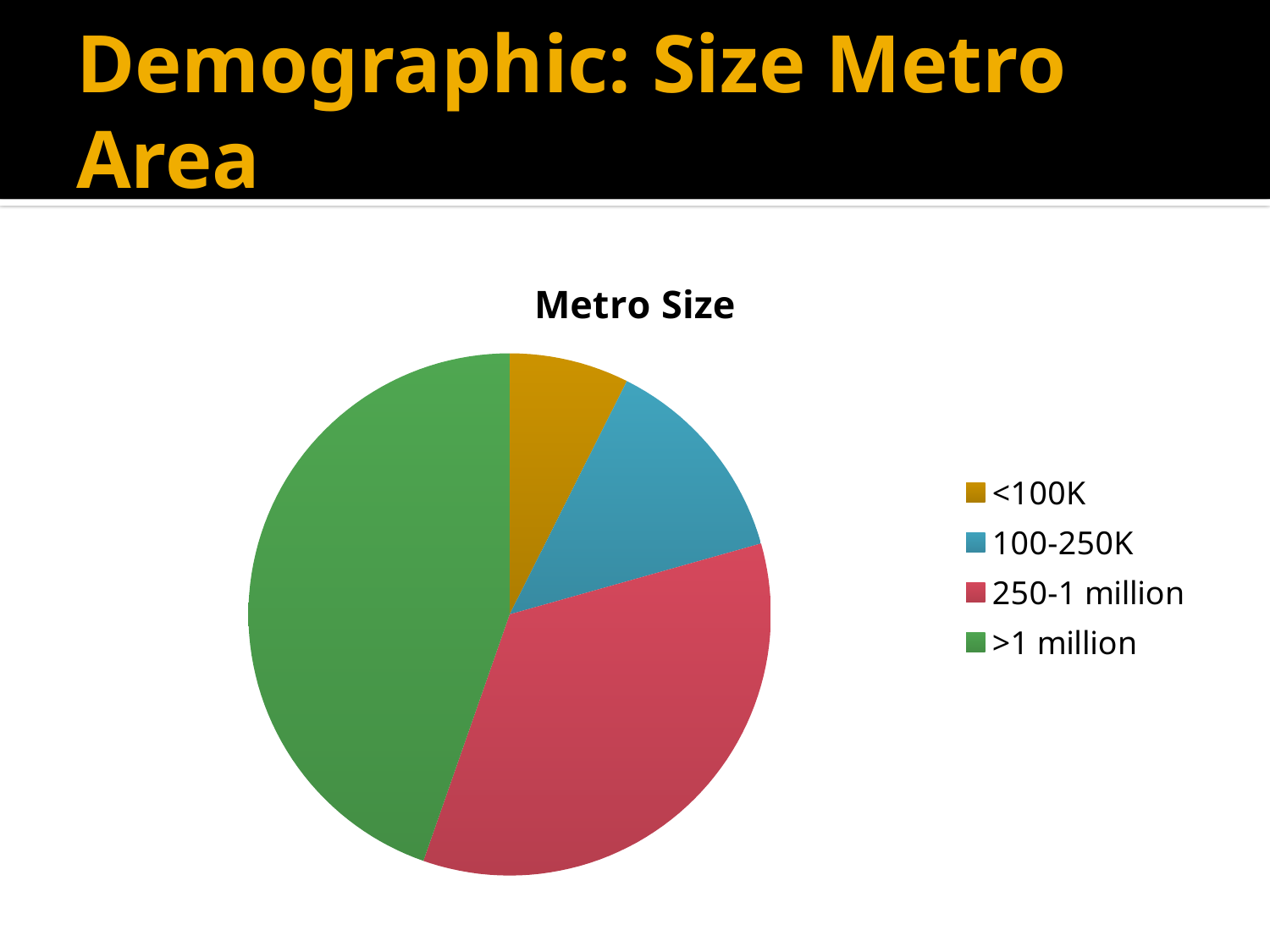
Which metro size category has the smallest slice of the pie? <100K How many slices does the pie chart have? 4 Which slice is larger, 100-250K or <100K? 100-250K Which colour represents the 250-1 million category in the pie chart? red How many entries does the legend list? 4 Which slice is larger, >1 million or 250-1 million? >1 million What kind of chart is shown on the slide? pie chart Which metro size category has the largest slice of the pie? >1 million Which slice is larger, 250-1 million or 100-250K? 250-1 million What is the title of the chart? Metro Size